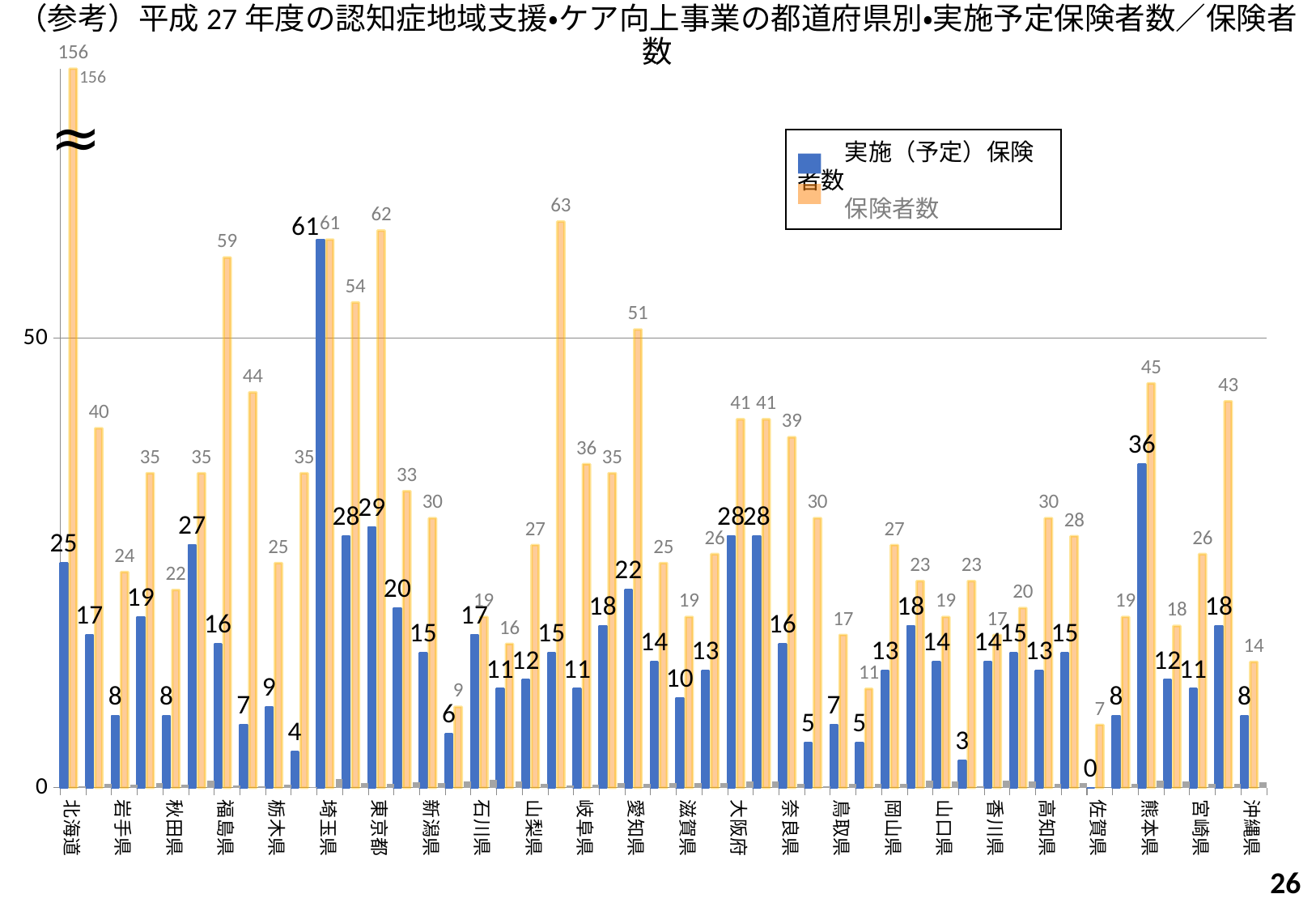
What kind of chart is shown on the slide? bar chart Is the 保険者数 value for 福島県 greater or less than 50? greater Which prefecture has the lowest 実施（予定）保険者数? 佐賀県 What is the 保険者数 value for 北海道? 156 What is the 保険者数 value for 愛知県? 51 Which prefecture has the highest 保険者数? 北海道 What is the 実施（予定）保険者数 value for 熊本県? 36 Which is larger, the 実施（予定）保険者数 for 大阪府 or for 奈良県? 大阪府 What is the 実施（予定）保険者数 value for 埼玉県? 61 Which prefecture has the highest 実施（予定）保険者数? 埼玉県 What is the difference between 保険者数 and 実施（予定）保険者数 for 東京都? 33 How many series does the legend list? 2